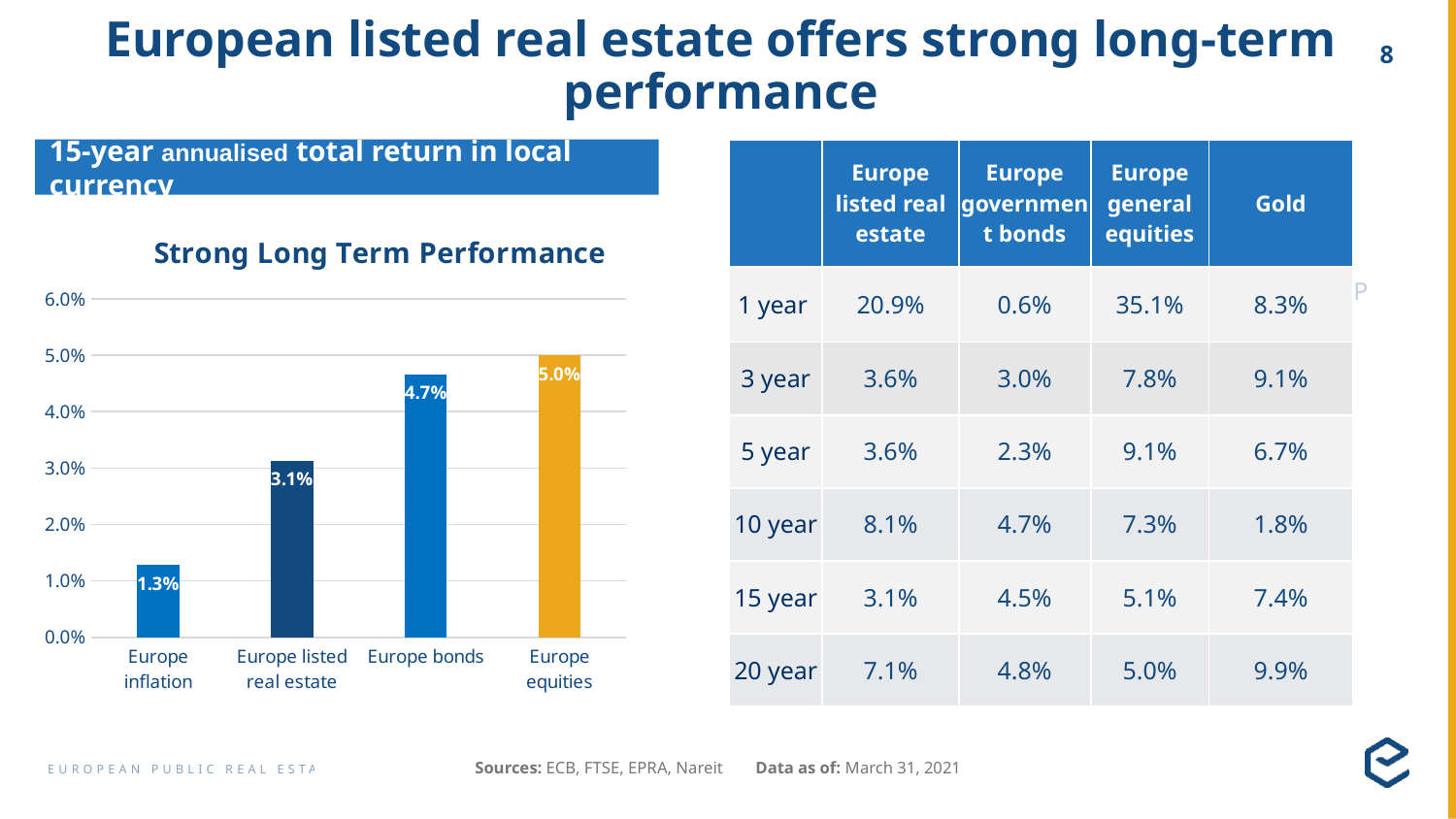
What is the difference between the values for Europe bonds and Europe listed real estate in the bar chart? 1.6% What is the value for Europe bonds in the bar chart? 4.7% What kind of chart is shown on the left of the slide? Bar chart What is the value for Europe listed real estate in the bar chart? 3.1% What is the value for Europe equities in the bar chart? 5.0% Is the value for Europe bonds in the bar chart greater or less than 4.0%? greater Which is larger in the bar chart, Europe listed real estate or Europe inflation? Europe listed real estate Which category has the lowest value in the bar chart? Europe inflation How many categories are shown in the bar chart? 4 What is the value for Europe inflation in the bar chart? 1.3% What is the title of the chart on the left of the slide? Strong Long Term Performance Which category has the highest value in the bar chart? Europe equities